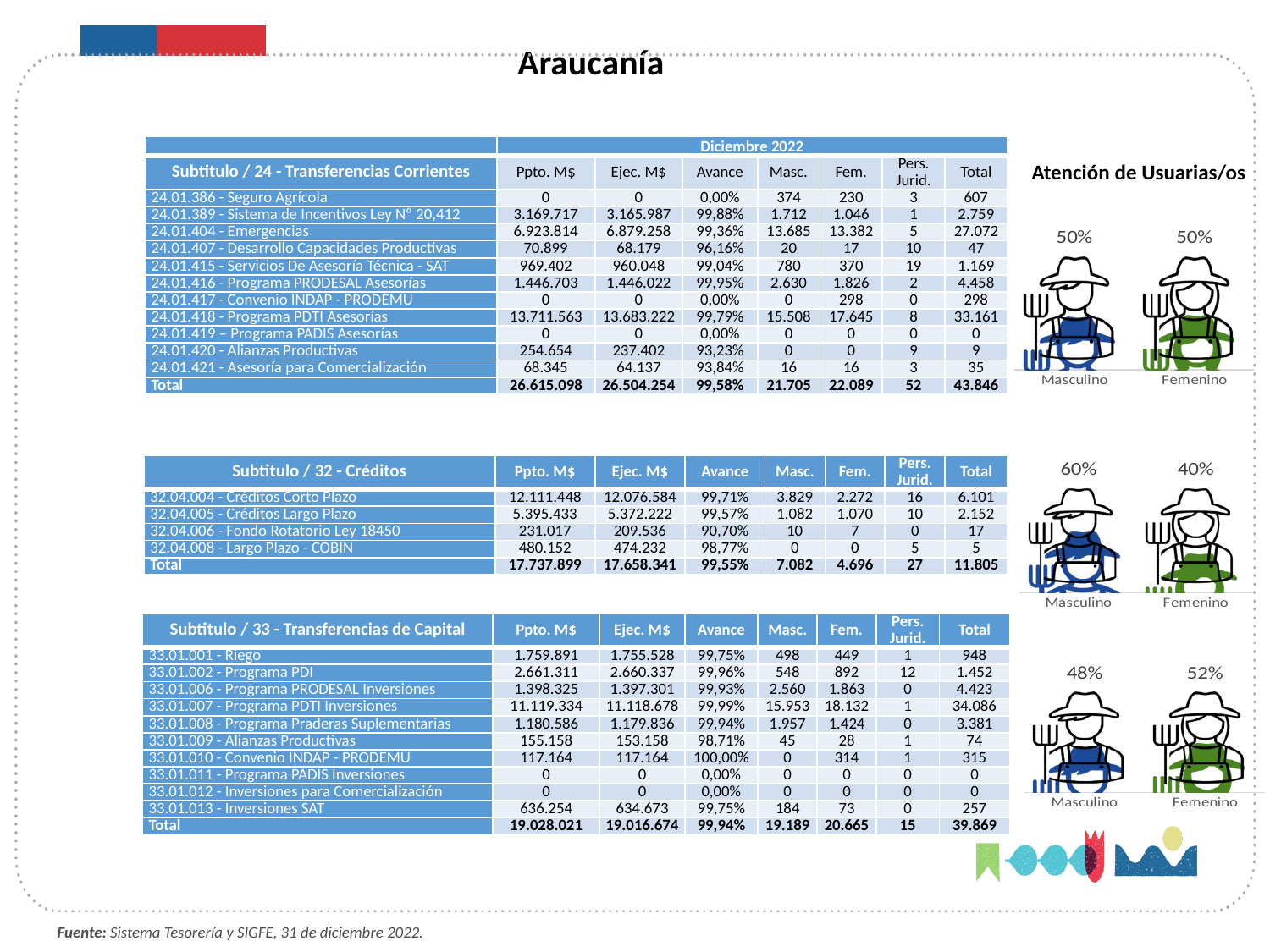
How many categories does each pictogram chart on the right side of the slide show? 2 In the bottom pictogram chart (next to the Subtítulo 33 - Transferencias de Capital table), what percentage is shown for Femenino? 52% In the middle pictogram chart (next to the Subtítulo 32 - Créditos table), what percentage is shown for Femenino? 40% What is the title shown above the top pictogram chart on the right side of the slide? Atención de Usuarias/os In the top 'Atención de Usuarias/os' pictogram chart, what percentage is shown for Masculino? 50% In the top 'Atención de Usuarias/os' pictogram chart, what percentage is shown for Femenino? 50% In the middle pictogram chart (next to the Subtítulo 32 - Créditos table), what percentage is shown for Masculino? 60% In the bottom pictogram chart, which category has the higher percentage, Masculino or Femenino? Femenino In the bottom pictogram chart, what is the difference between the Femenino and Masculino percentages? 4% In the middle pictogram chart, which category has the higher percentage, Masculino or Femenino? Masculino In the bottom pictogram chart (next to the Subtítulo 33 - Transferencias de Capital table), what percentage is shown for Masculino? 48% In the middle pictogram chart, what is the difference between the Masculino and Femenino percentages? 20%